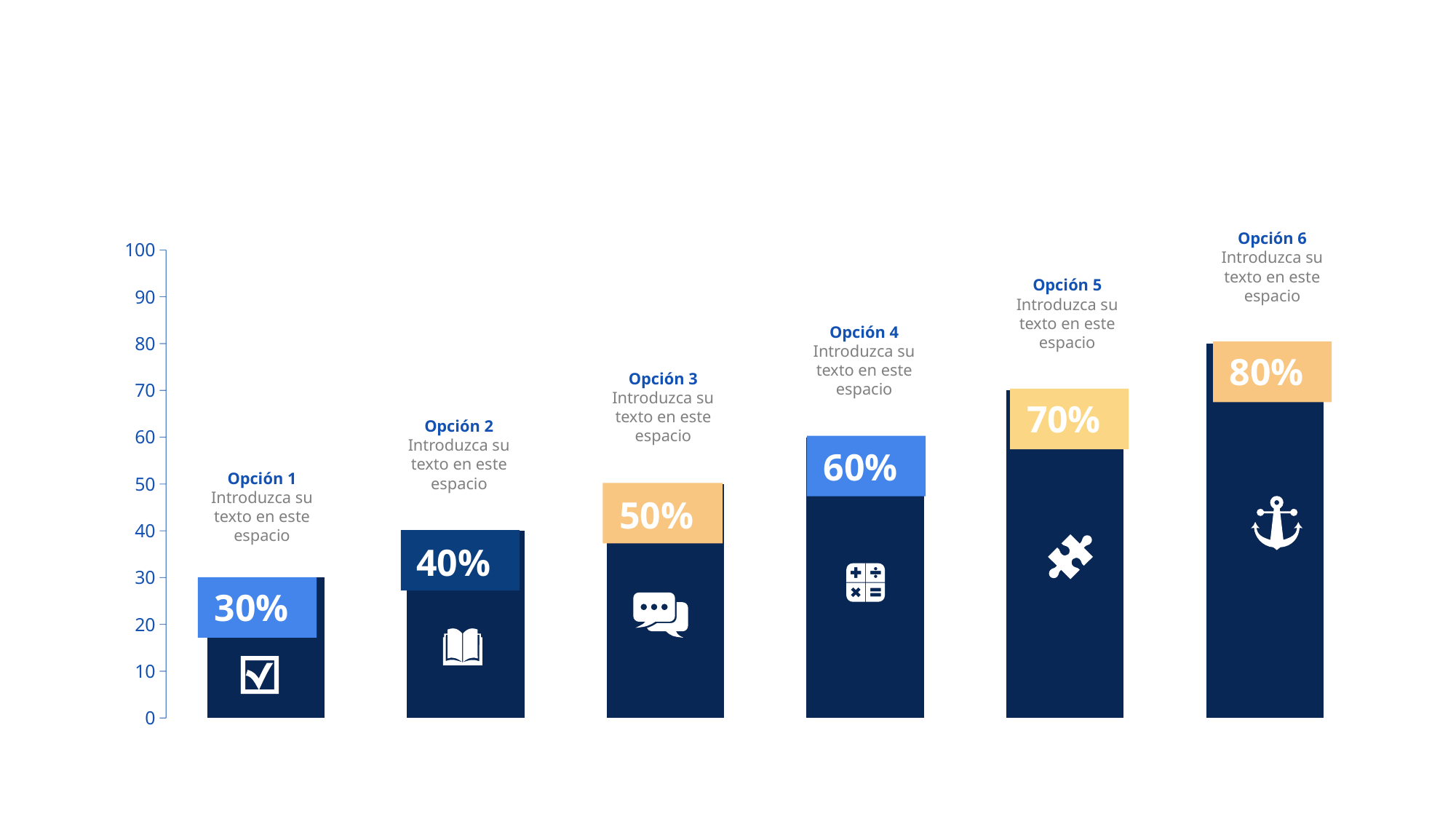
What is the maximum value shown on the vertical axis? 100 Do the values rise or fall from Opción 1 to Opción 6? rise Is the value for Opción 5 greater or less than 60? greater Which option has the lowest value? Opción 1 How many options (bars) are shown in the chart? 6 What is the difference between the values for Opción 5 and Opción 2? 30% What is the value for Opción 6? 80% What kind of chart is shown on the slide? bar chart Which option has the highest value? Opción 6 Which is larger, the value for Opción 3 or the value for Opción 4? Opción 4 What is the value for Opción 1? 30% What is the value for Opción 4? 60%